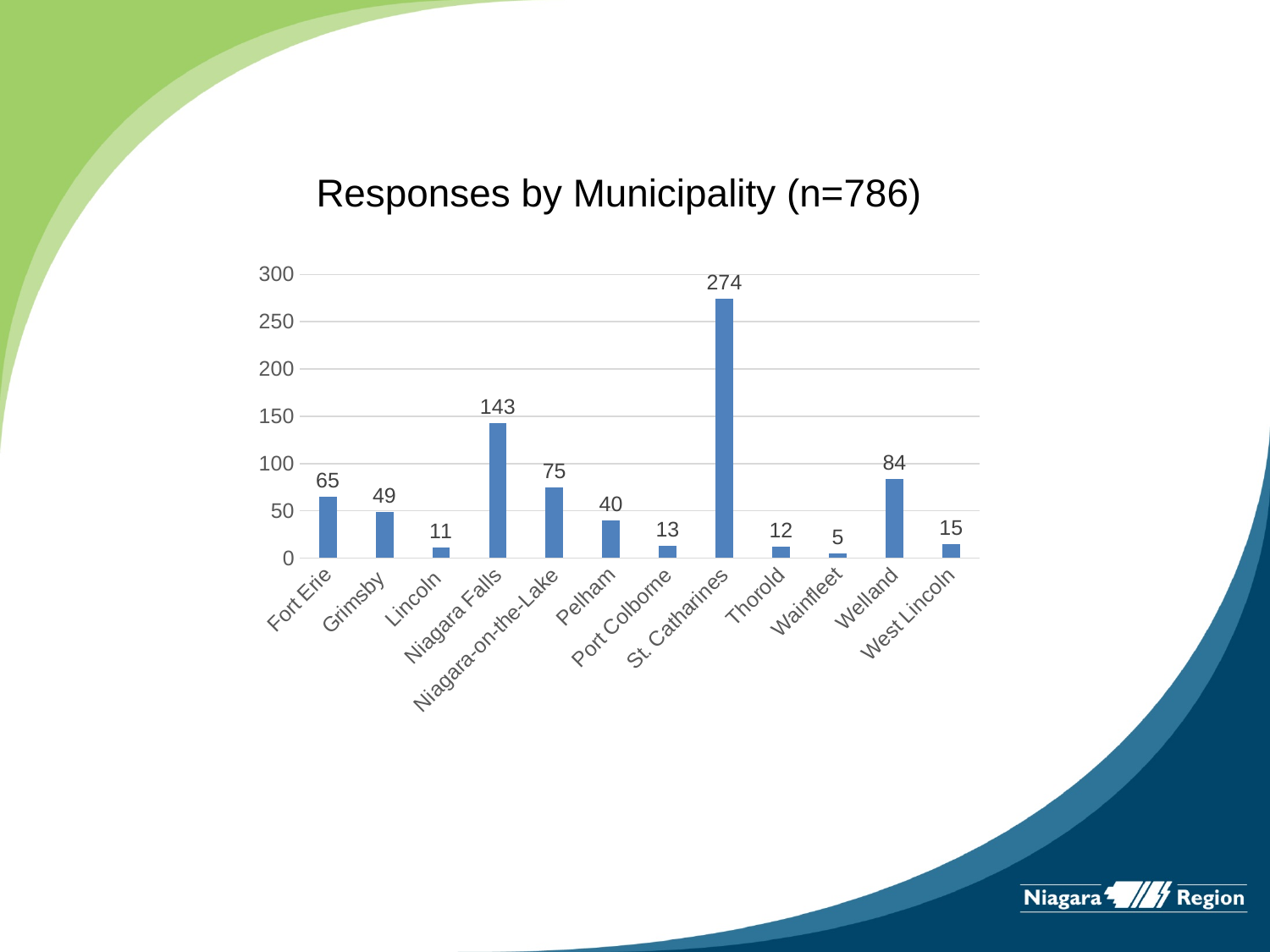
What kind of chart is shown on the slide? Bar chart Which municipality has the lowest number of responses? Wainfleet What is the value for St. Catharines? 274 Which has a larger value, Grimsby or Pelham? Grimsby What is the value for Niagara Falls? 143 How many municipalities are shown on the x axis? 12 What is the title of the chart? Responses by Municipality (n=786) What is the value for Wainfleet? 5 What is the value for Niagara-on-the-Lake? 75 What is the difference between the values for Welland and Fort Erie? 19 Which municipality has the highest number of responses? St. Catharines What is the difference between the values for St. Catharines and Niagara Falls? 131